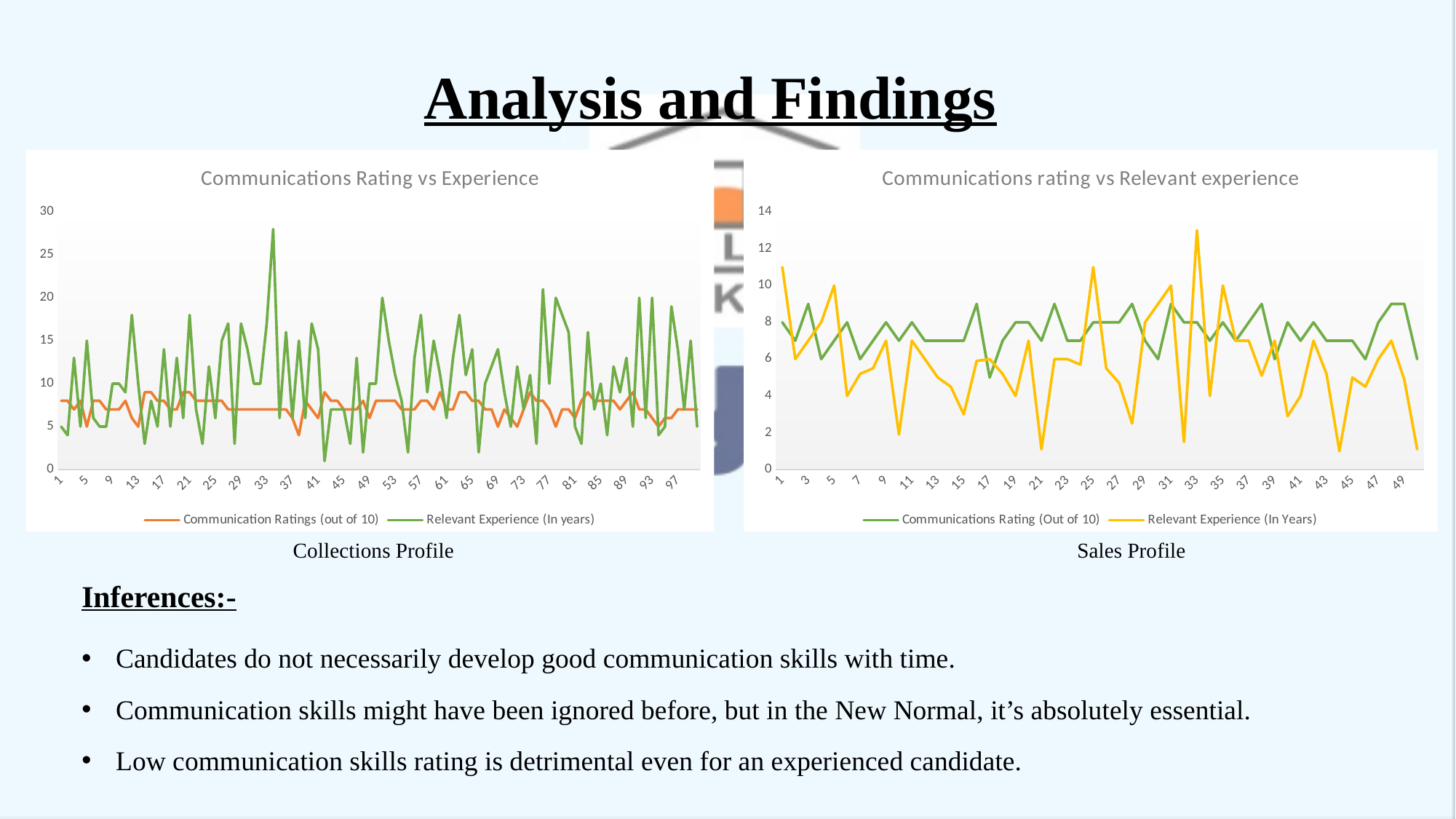
In the 'Communications Rating vs Experience' chart, is the Relevant Experience value at point 34 greater or less than 25? greater In the 'Communications rating vs Relevant experience' chart, is the Relevant Experience value at point 1 greater or less than 10? greater In the 'Communications Rating vs Experience' chart, at point 34 which series has the larger value, Communication Ratings or Relevant Experience? Relevant Experience (In years) How many series does the legend of the 'Communications rating vs Relevant experience' chart list? 2 What kind of chart is the 'Communications Rating vs Experience' chart (Collections Profile)? Line chart In the 'Communications rating vs Relevant experience' chart, is the Relevant Experience value at point 10 greater or less than 4? less What kind of chart is the 'Communications rating vs Relevant experience' chart (Sales Profile)? Line chart In the 'Communications Rating vs Experience' chart, which series reaches the highest value on the chart? Relevant Experience (In years) In the 'Communications rating vs Relevant experience' chart, which series is drawn in yellow? Relevant Experience (In Years) In the 'Communications Rating vs Experience' chart, which series is drawn in orange? Communication Ratings (out of 10) How many series does the legend of the 'Communications Rating vs Experience' chart list? 2